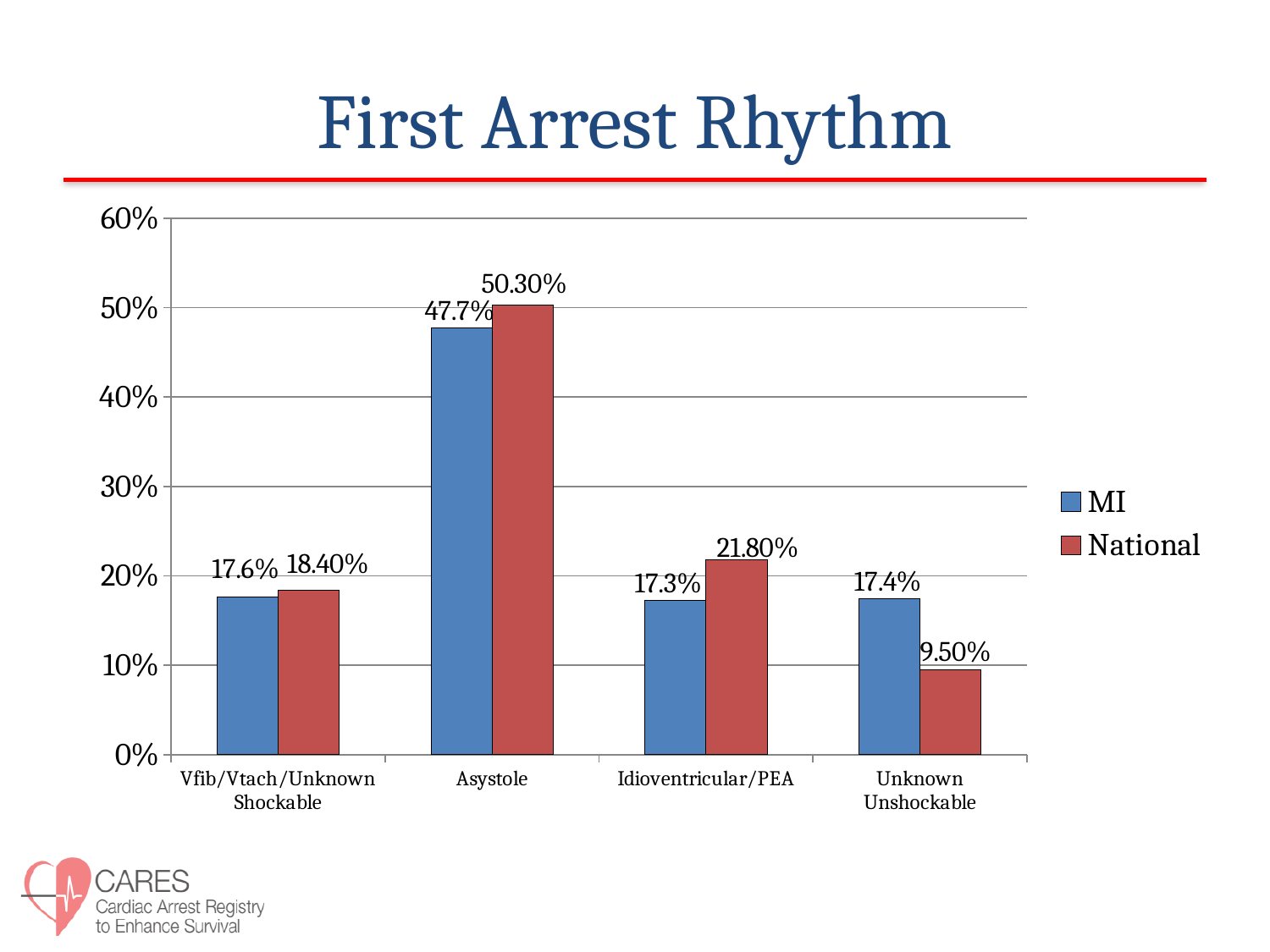
How many series does the legend list? 2 What is the National value for Unknown Unshockable? 9.50% What is the National value for Idioventricular/PEA? 21.80% Which category has the lowest National value? Unknown Unshockable What is the difference between the National and MI values for Idioventricular/PEA? 4.5% How many categories are shown on the x axis? 4 What is the MI value for Asystole? 47.7% Is the National value for Asystole greater or less than 40%? greater For Unknown Unshockable, which is larger, the MI value or the National value? MI What is the MI value for Vfib/Vtach/Unknown Shockable? 17.6% What kind of chart is shown on the slide? bar chart Which category has the highest National value? Asystole